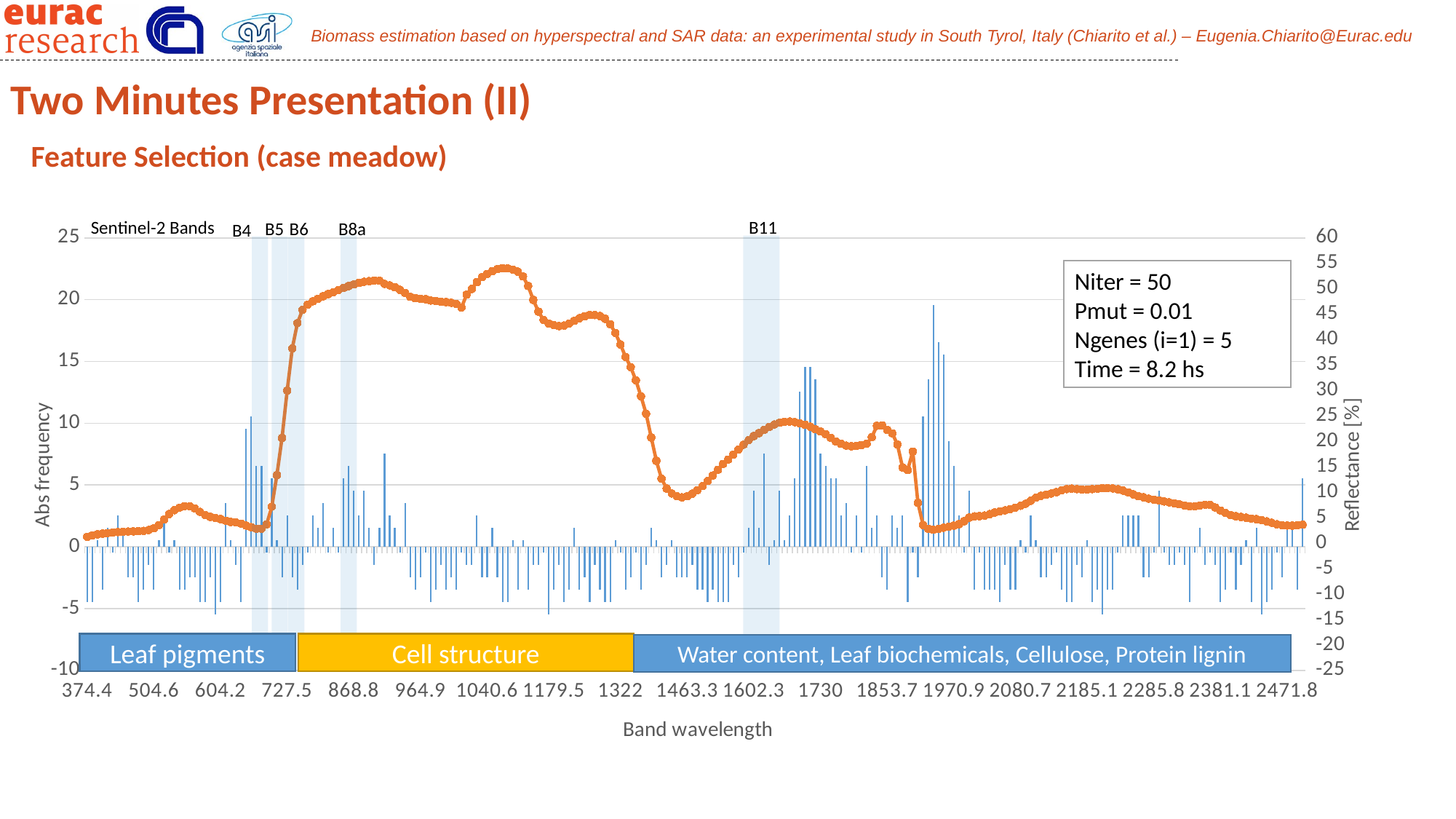
Does the reflectance line rise or fall between the 374.4 and 868.8 wavelength labels? rise Does the reflectance line rise or fall between the 1179.5 and 1463.3 wavelength labels? fall Near which x-axis label does the reflectance line reach its highest value? 1040.6 Is the reflectance value at the 374.4 wavelength greater or less than 10? less Is the reflectance value at the 1322 wavelength greater or less than 20? greater What is the title of the left vertical axis? Abs frequency What is the title of the right vertical axis? Reflectance [%] Is the tallest Abs frequency bar greater or less than 15 on the left axis? greater What kind of chart is shown on the slide? A combination bar and line chart Which Sentinel-2 band is highlighted near the 1602.3 wavelength label? B11 How many Sentinel-2 bands are labelled as shaded regions on the chart? 5